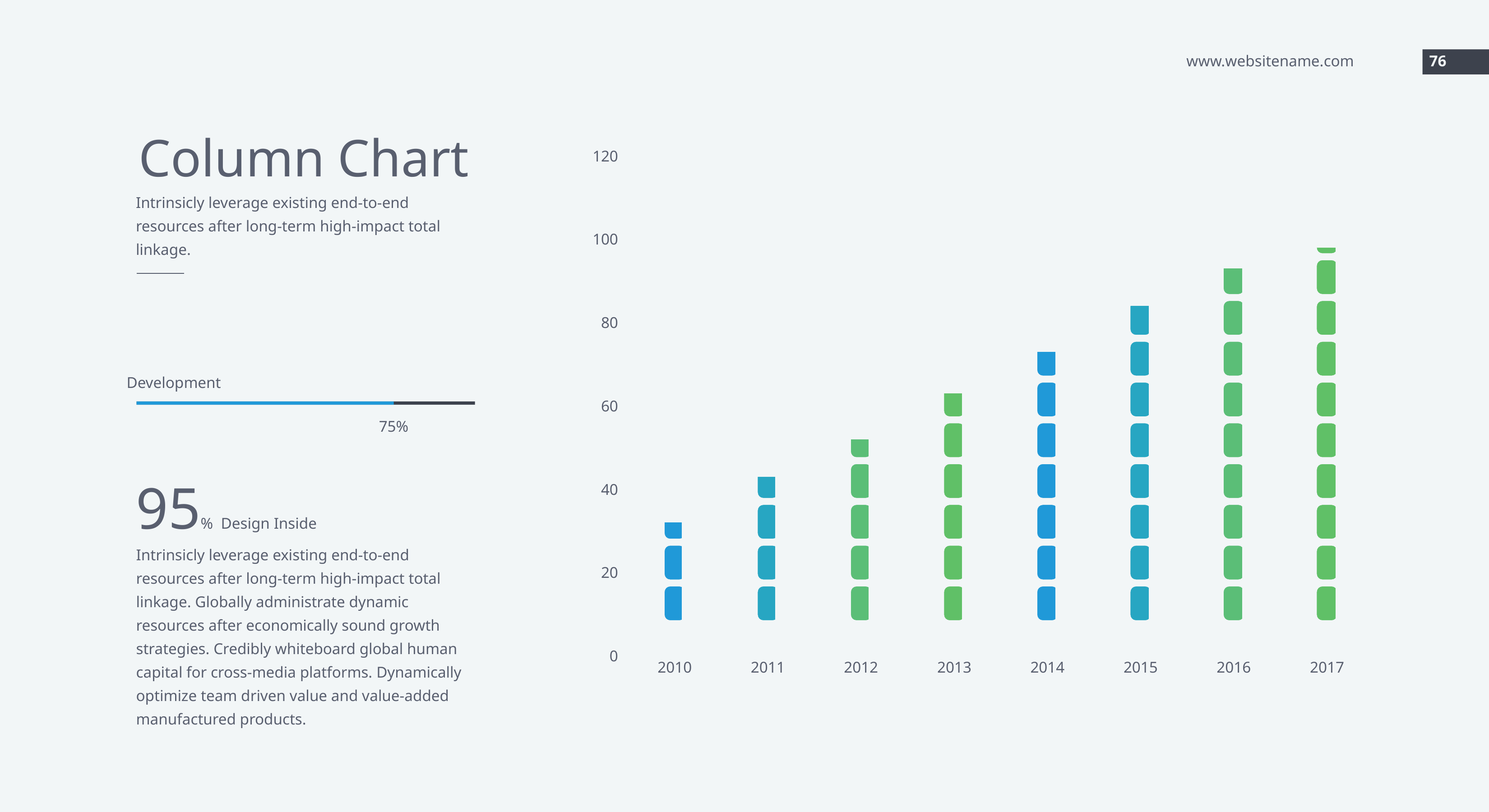
How many years are shown on the x axis of the chart? 8 Which year has the highest value in the chart? 2017 Which year has the lowest value in the chart? 2010 Is the value for 2014 greater or less than 60? greater Which is larger, the value for 2013 or the value for 2015? 2015 What is the first year shown on the x axis? 2010 What is the highest tick value shown on the y axis? 120 Is the value for 2012 greater or less than 60? less Do the values rise or fall from 2010 to 2017? rise What kind of chart is shown on the slide? bar chart Is the value for 2010 greater or less than 40? less